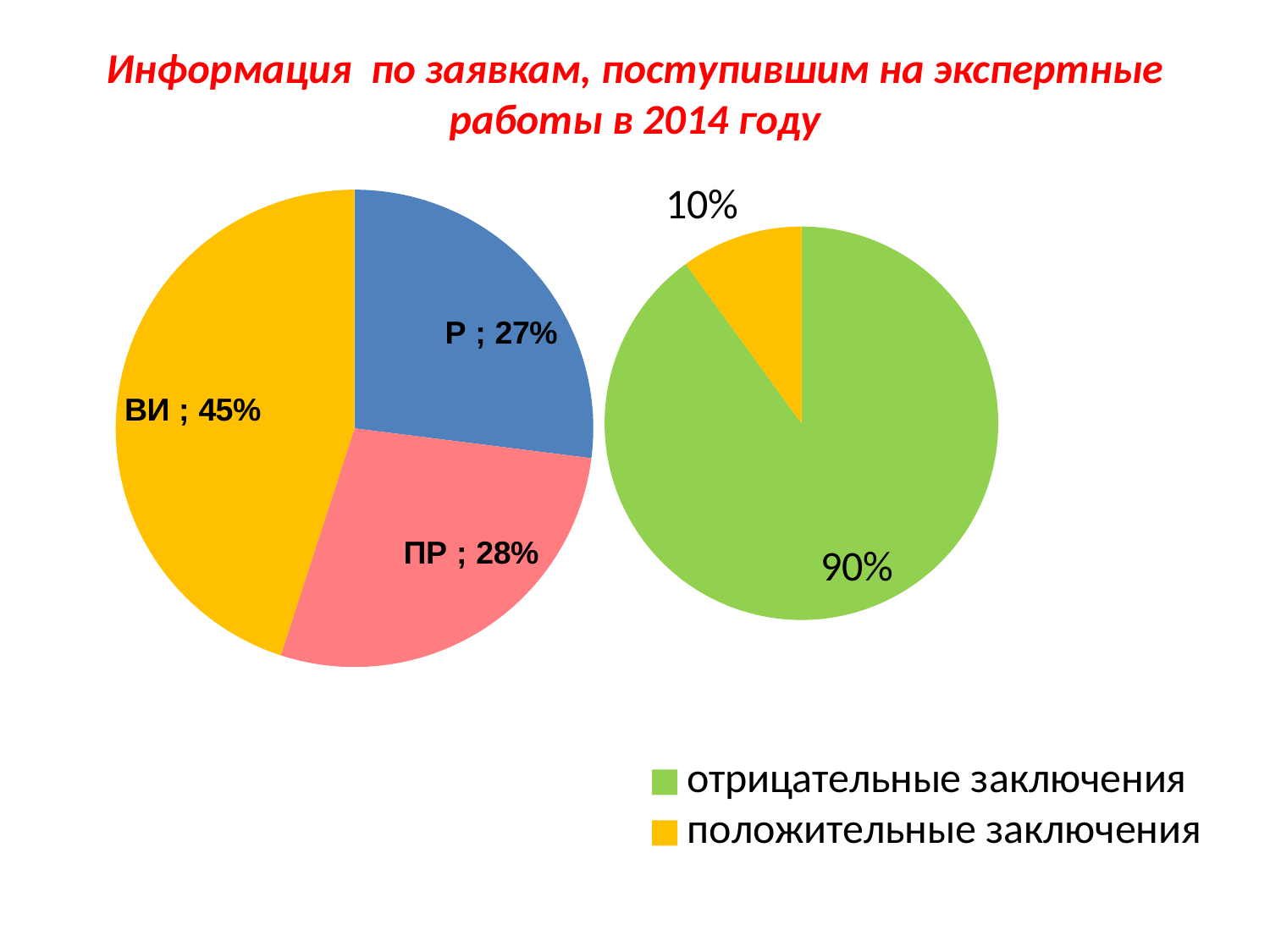
In the left pie chart, how many slices are there? 3 In the right pie chart, what is the share of отрицательные заключения? 90% What type of chart is the left chart on the slide? pie chart In the left pie chart, what is the share for Р? 27% In the left pie chart, which category has the smallest share? Р In the left pie chart, what is the share for ВИ? 45% In the left pie chart, what is the difference between the shares of ВИ and ПР? 17% In the left pie chart, which category has the largest share? ВИ In the left pie chart, what is the share for ПР? 28% In the right pie chart, what is the share of положительные заключения? 10% In the right pie chart, which is larger: отрицательные заключения or положительные заключения? отрицательные заключения How many entries does the legend of the right pie chart list? 2